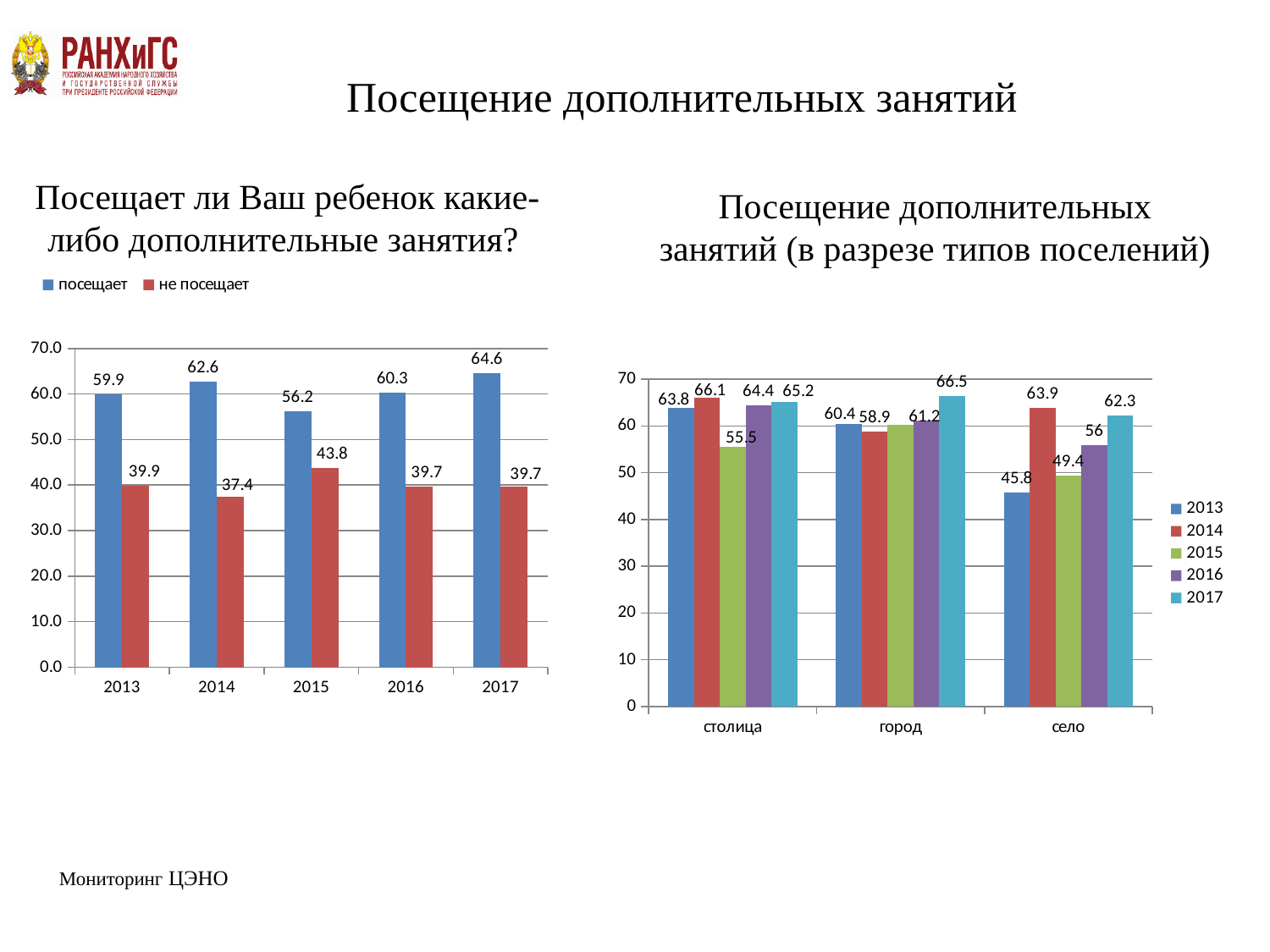
In the left chart (Посещает ли Ваш ребенок какие-либо дополнительные занятия?), how many series does the legend list? 2 In the right chart (Посещение дополнительных занятий (в разрезе типов поселений)), how many series does the legend list? 5 What kind of chart is the right chart (Посещение дополнительных занятий (в разрезе типов поселений))? bar chart In the left chart (Посещает ли Ваш ребенок какие-либо дополнительные занятия?), how many years are shown on the x axis? 5 In the left chart (Посещает ли Ваш ребенок какие-либо дополнительные занятия?), what is the value for посещает in 2017? 64.6 In the left chart (Посещает ли Ваш ребенок какие-либо дополнительные занятия?), what is the difference between посещает and не посещает in 2014? 25.2 In the right chart (Посещение дополнительных занятий (в разрезе типов поселений)), what is the value for 2014 in село? 63.9 In the right chart (Посещение дополнительных занятий (в разрезе типов поселений)), which is larger for столица: 2014 or 2015? 2014 In the left chart (Посещает ли Ваш ребенок какие-либо дополнительные занятия?), what is the value for не посещает in 2015? 43.8 In the right chart (Посещение дополнительных занятий (в разрезе типов поселений)), what is the value for 2017 in город? 66.5 In the right chart (Посещение дополнительных занятий (в разрезе типов поселений)), which year has the lowest value in село? 2013 In the left chart (Посещает ли Ваш ребенок какие-либо дополнительные занятия?), which year has the lowest value for посещает? 2015